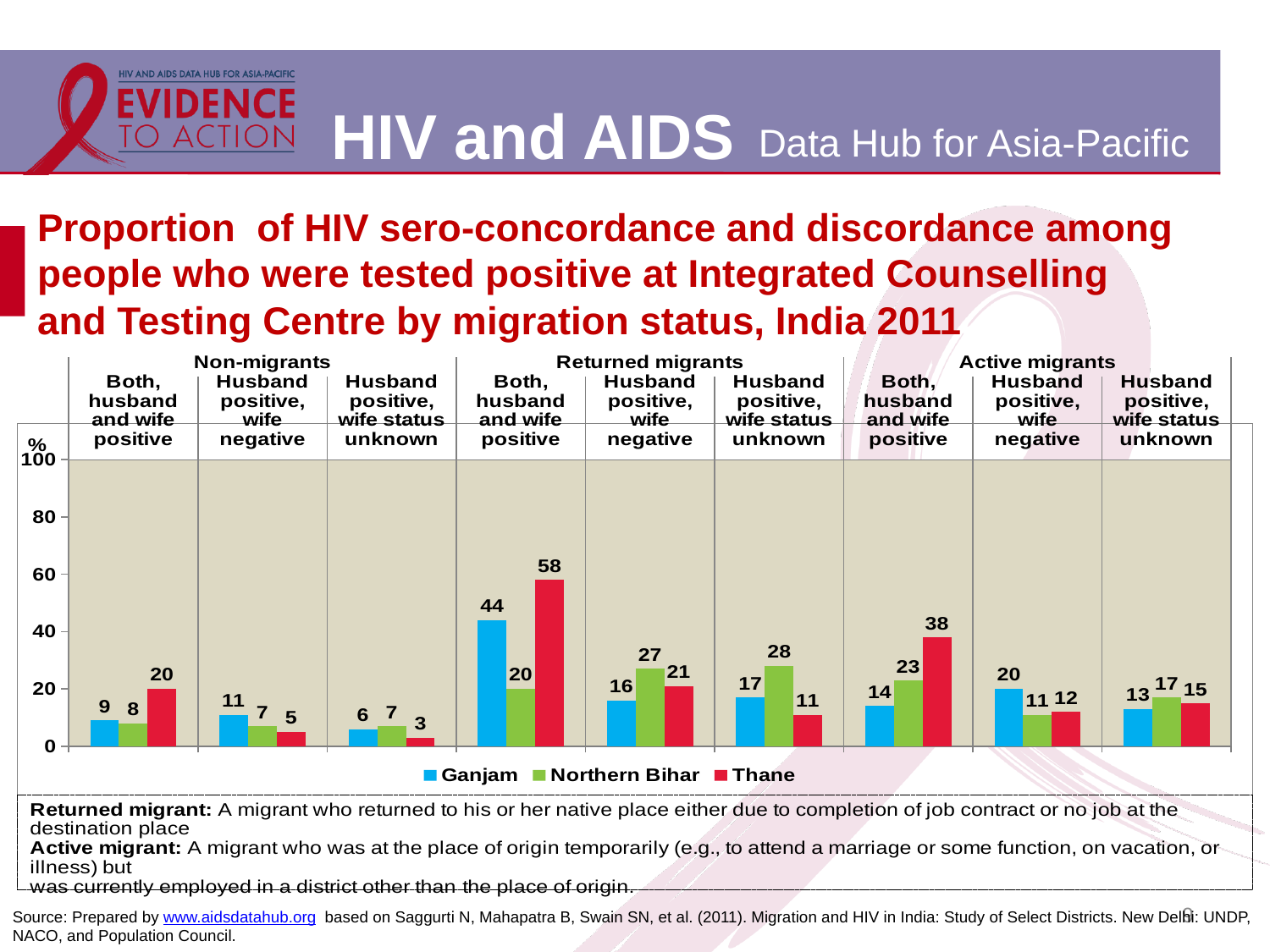
What is the value for Thane in the 'Both, husband and wife positive' category among returned migrants? 58 What is the value for Ganjam in the 'Both, husband and wife positive' category among non-migrants? 9 What kind of chart is shown on the slide? Bar chart Which colour represents Northern Bihar in the chart? Green What is the difference between the Thane and Ganjam values in the 'Both, husband and wife positive' category among returned migrants? 14 How many series does the legend list? 3 Which series has the lowest value in the 'Husband positive, wife status unknown' category among non-migrants? Thane Among active migrants in the 'Both, husband and wife positive' category, which is larger: Ganjam or Northern Bihar? Northern Bihar What is the value for Thane in the 'Both, husband and wife positive' category among active migrants? 38 How many categories are shown along the x axis of the chart? 9 What is the value for Northern Bihar in the 'Husband positive, wife status unknown' category among returned migrants? 28 Which series has the highest value in the 'Both, husband and wife positive' category among returned migrants? Thane